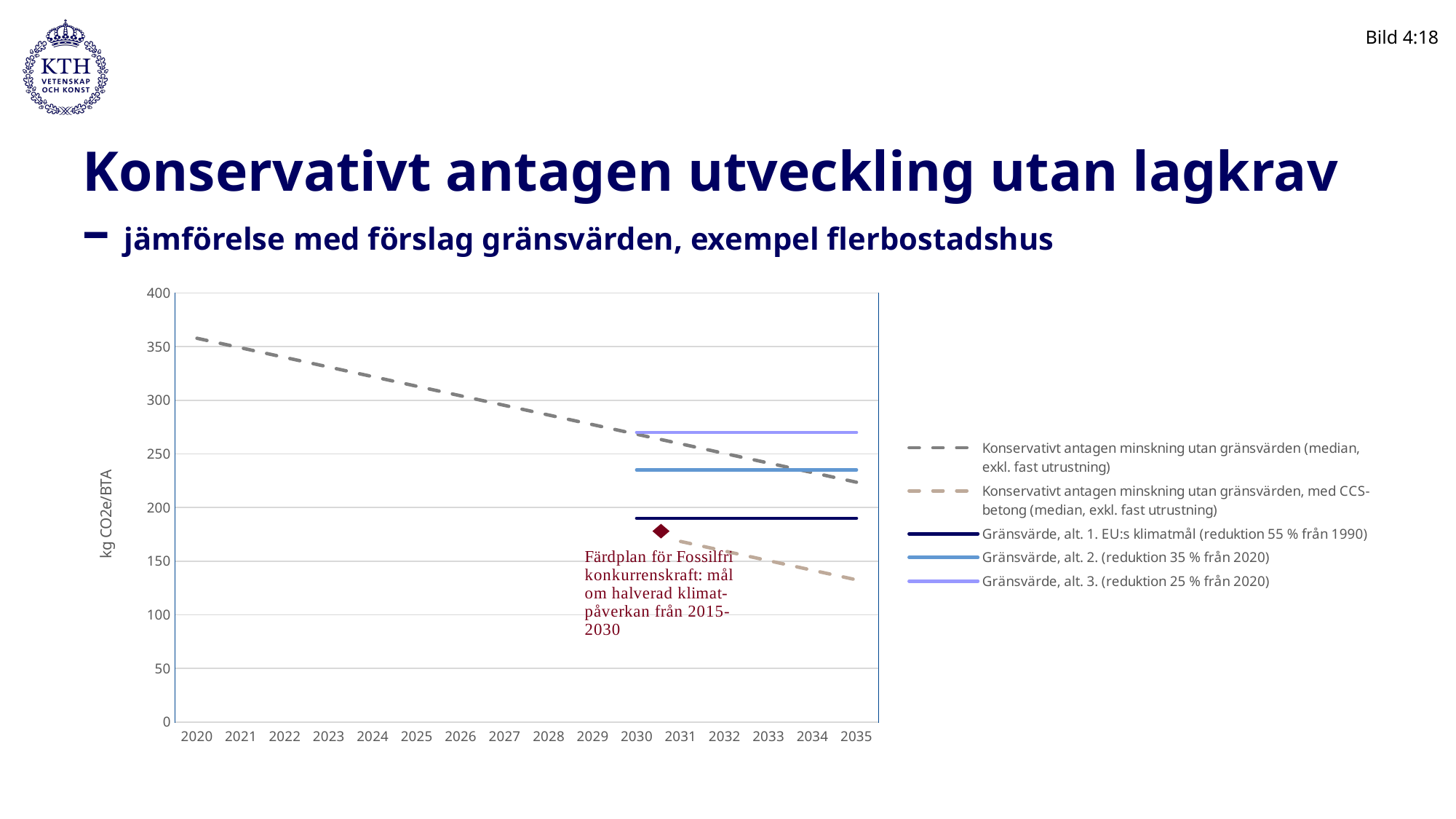
Is the value of the grey dashed line in 2020 greater or less than 300? greater Does the grey dashed line (Konservativt antagen minskning utan gränsvärden) rise or fall from 2020 to 2035? fall How many series does the legend list? 5 Is the value of the Gränsvärde, alt. 2 line greater or less than 250? less What is the label on the y axis? kg CO2e/BTA Is the value of the Gränsvärde, alt. 3 line greater or less than 250? greater In 2035, which is higher: the grey dashed line or the Gränsvärde, alt. 3 line? Gränsvärde, alt. 3 Which of the three Gränsvärde lines is the lowest? Gränsvärde, alt. 1 What kind of chart is shown on the slide? line chart Which of the three Gränsvärde lines is the highest? Gränsvärde, alt. 3 How many years are labelled on the x axis? 16